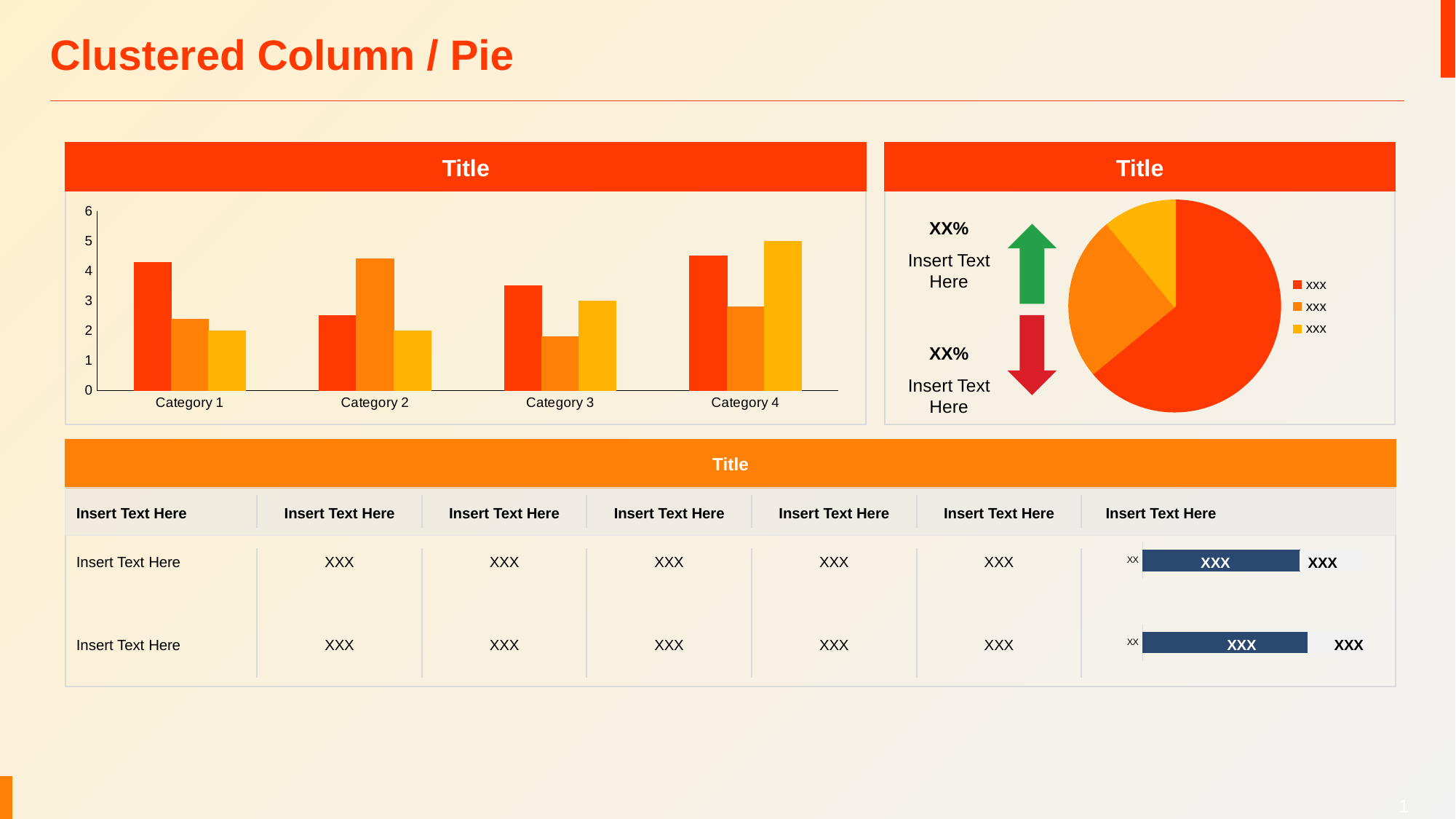
In the bar chart on the left, is the value of the orange bar for Category 3 greater or less than 2? less In the bar chart on the left, which category contains the tallest bar? Category 4 In the bar chart on the left, for Category 2, which is larger: the red bar or the orange bar? the orange bar In the pie chart on the right, which colour slice is the largest? red In the bar chart on the left, is the value of the red bar for Category 1 greater or less than 4? greater In the bar chart on the left, how many bars are there in each category? 3 In the bar chart on the left, what is the value of the yellow bar for Category 4? 5 In the bar chart on the left, how many categories are shown on the x axis? 4 In the bar chart on the left, is the value of the red bar for Category 3 greater or less than 3? greater What kind of chart is the chart on the left of the slide? bar chart What kind of chart is the chart on the right of the slide? pie chart How many entries does the legend of the pie chart on the right list? 3